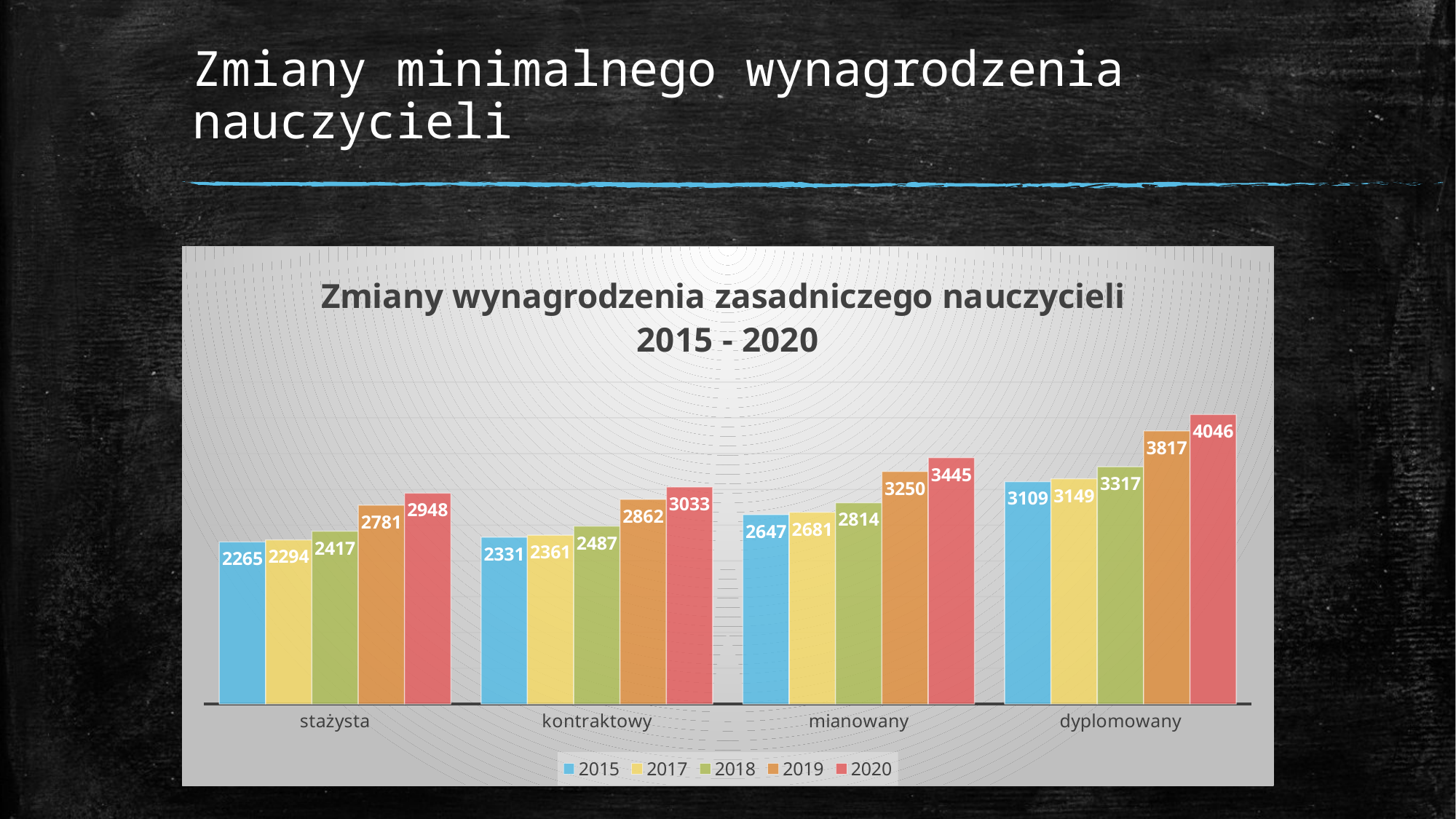
How many series does the legend list? 5 Which category has the lowest value in 2015? stażysta What is the value for stażysta in 2015? 2265 What is the difference between the 2020 and 2019 values for stażysta? 167 Which category has the highest value in 2020? dyplomowany Which is larger: the 2020 value for kontraktowy or the 2015 value for dyplomowany? 2015 value for dyplomowany What kind of chart is shown? bar chart What is the value for mianowany in 2018? 2814 How many categories are shown on the x axis? 4 What is the value for kontraktowy in 2019? 2862 What is the difference between the 2020 and 2015 values for dyplomowany? 937 What is the value for dyplomowany in 2020? 4046